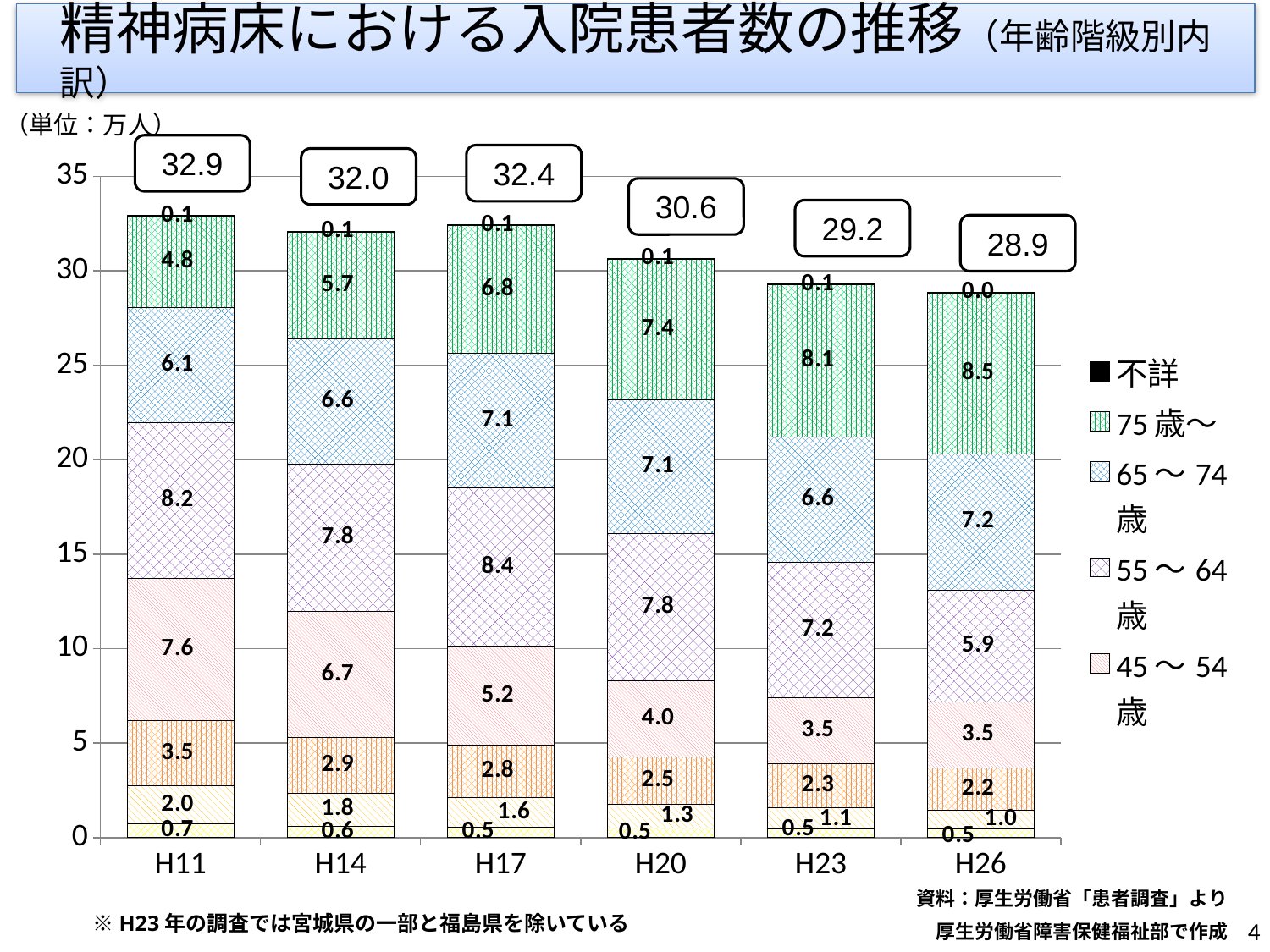
How many years (categories) are shown on the x axis? 6 What is the value for the 45～54歳 segment in H11? 7.6 What is the value for the 不詳 segment in H26? 0.0 Which is larger, the 55～64歳 value in H17 or in H26? H17 What is the value for the 75歳～ segment in H26? 8.5 Does the 45～54歳 segment rise or fall from H11 to H26? fall Which year has the highest total number of inpatients? H11 What kind of chart is shown on the slide? stacked bar chart What is the difference between the 75歳～ value in H26 and in H11? 3.7 What is the total of the stacked bar for H20? 30.6 Which year has the lowest total number of inpatients? H26 Does the 75歳～ segment rise or fall from H11 to H26? rise